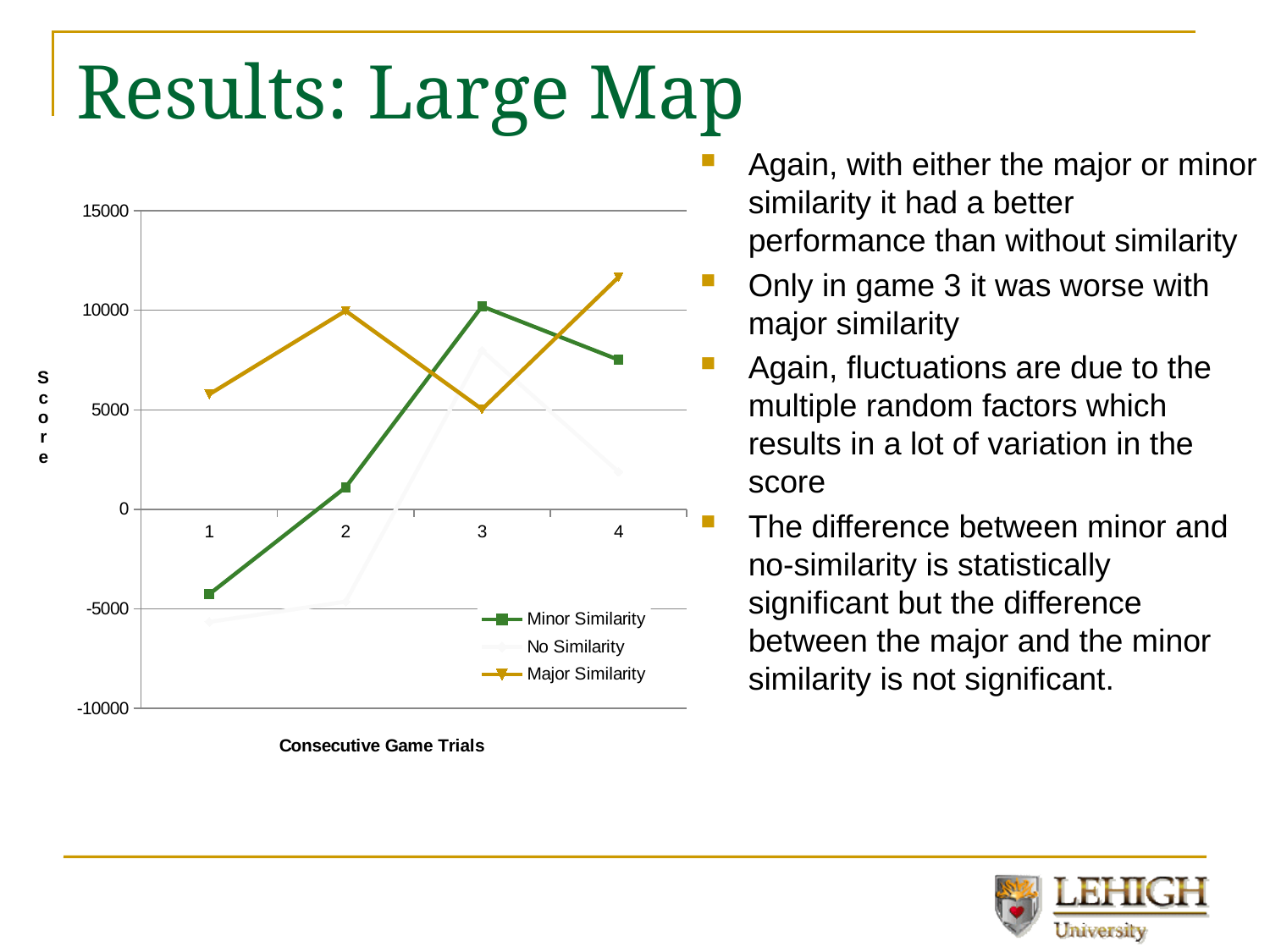
Is the Minor Similarity score at trial 3 greater or less than 5000? greater What kind of chart is shown on the slide? line chart How many game trials are plotted along the x axis? 4 What is the title of the x axis of the chart? Consecutive Game Trials At which trial does the Minor Similarity series have its lowest score? 1 At which trial does the Major Similarity series reach its highest score? 4 At trial 3, which series has the higher score, Minor Similarity or Major Similarity? Minor Similarity Is the Minor Similarity score at trial 1 greater or less than 0? less Is the Major Similarity score at trial 4 greater or less than 10000? greater How many series does the chart's legend list? 3 At trial 1, which series has the higher score, Minor Similarity or Major Similarity? Major Similarity